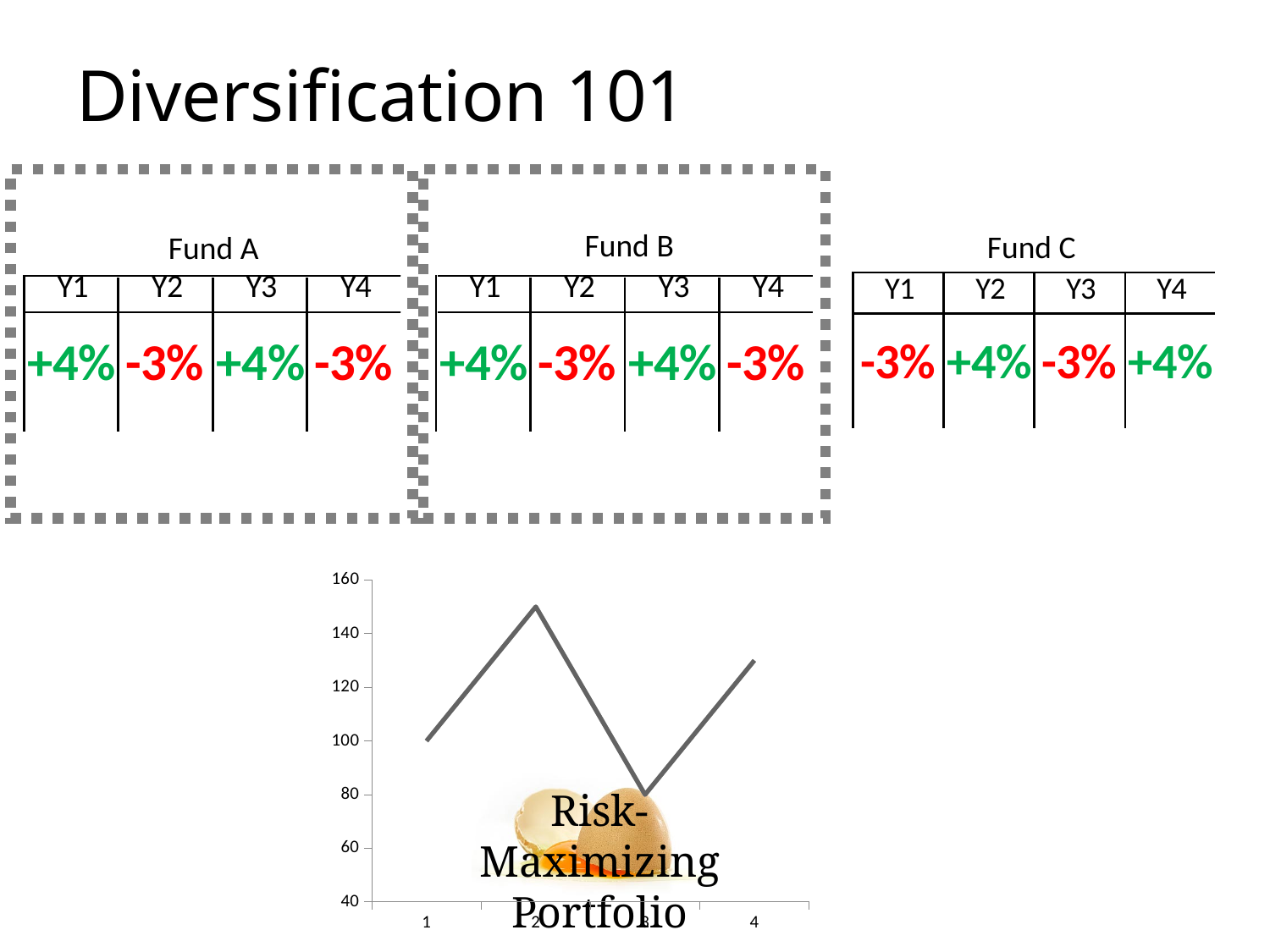
What is the value at x = 1 on the line chart? 100 At which x value does the line chart reach its highest point? 2 At which x value does the line chart reach its lowest point? 3 What is the value at x = 3 on the line chart? 80 Is the value at x = 4 on the line chart greater or less than 120? greater What is the lowest value shown on the y axis of the line chart? 40 Which is larger on the line chart, the value at x = 1 or the value at x = 3? x = 1 What is the difference between the values at x = 1 and x = 3 on the line chart? 20 Is the value at x = 4 on the line chart greater or less than 140? less Is the value at x = 2 on the line chart greater or less than 140? greater How many points are plotted on the line chart? 4 What kind of chart is shown at the bottom of the slide? line chart